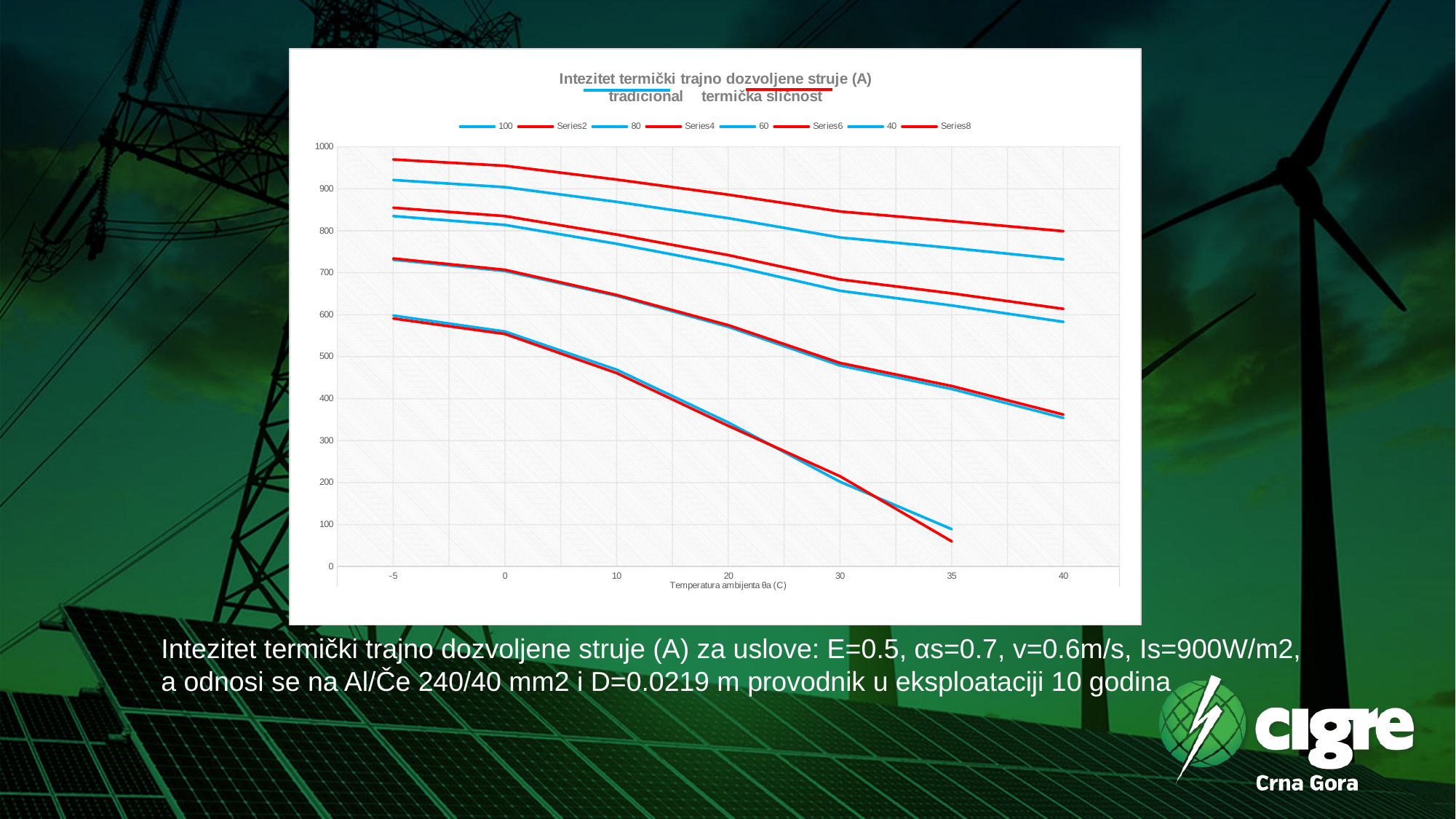
How many series does the legend list? 8 What is the label of the x axis? Temperatura ambijenta θa (C) What kind of chart is shown on the slide? line chart Which series has the highest value at 40? Series2 Is the value of Series2 at -5 greater or less than 900? greater Is the value of series 40 at 20 greater or less than 400? less Is the value of series 60 at 40 greater or less than 400? less Do the values of the series rise or fall as the ambient temperature increases? fall Which series has the lowest value at 35? Series8 How many temperature values are marked on the x axis? 7